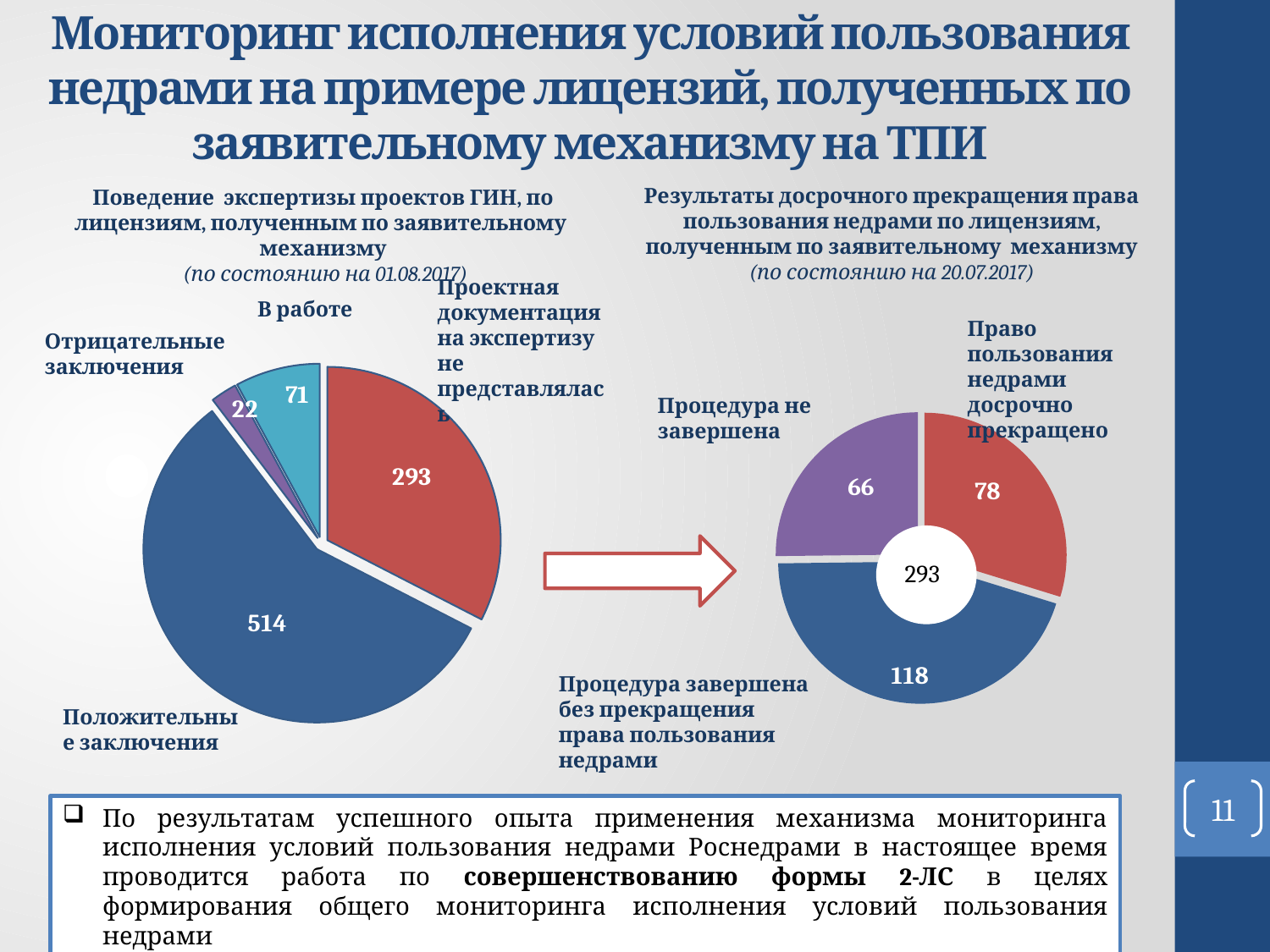
What number is shown in the centre of the right doughnut chart? 293 On the right chart, what is the value for 'Процедура не завершена'? 66 On the left pie chart, which category has the smallest slice? Отрицательные заключения On the left pie chart, what is the value for 'В работе'? 71 On the right chart, what is the value for 'Право пользования недрами досрочно прекращено'? 78 On the left pie chart, what is the value for 'Положительные заключения'? 514 On the left pie chart, which category has the largest slice? Положительные заключения On the right chart, which category has the largest slice? Процедура завершена без прекращения права пользования недрами On the right chart, which is larger: 'Право пользования недрами досрочно прекращено' or 'Процедура не завершена'? Право пользования недрами досрочно прекращено On the left pie chart, what is the difference between 'Положительные заключения' and 'Проектная документация на экспертизу не представлялась'? 221 How many slices does the left pie chart have? 4 On the left pie chart, what is the value for 'Отрицательные заключения'? 22